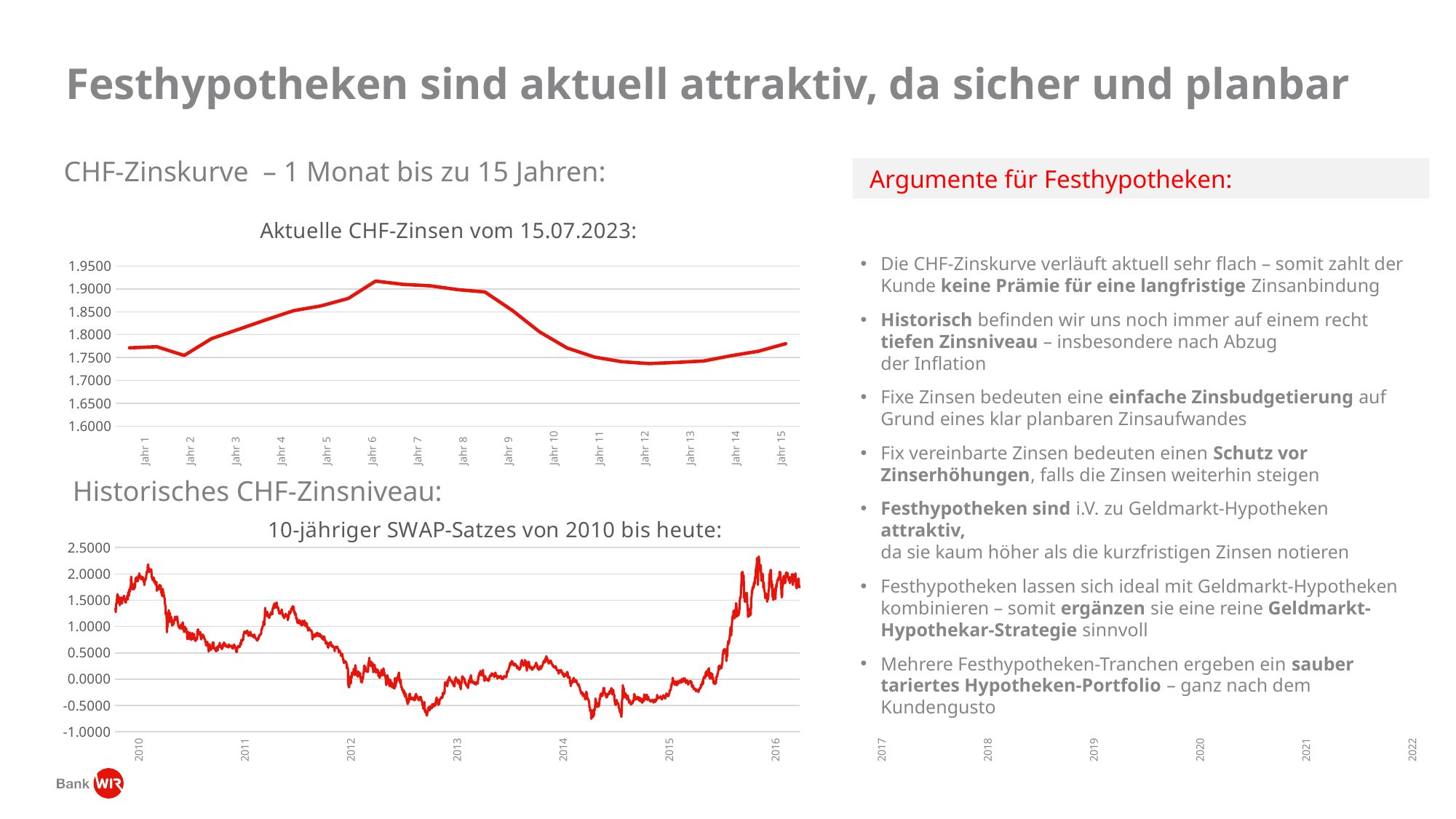
In the 'Aktuelle CHF-Zinsen vom 15.07.2023' chart, which category has the highest value? Jahr 6 In the 'Aktuelle CHF-Zinsen vom 15.07.2023' chart, do the values rise or fall from Jahr 6 to Jahr 12? fall In the 'Aktuelle CHF-Zinsen vom 15.07.2023' chart, which is larger, the value for Jahr 5 or the value for Jahr 10? Jahr 5 What kind of chart is the 'Aktuelle CHF-Zinsen vom 15.07.2023' chart? Line chart In the '10-jähriger SWAP-Satzes von 2010 bis heute' chart, is the lowest point of the line greater or less than 0.0000? less How many categories (Jahr 1 to Jahr 15) are plotted on the x axis of the 'Aktuelle CHF-Zinsen vom 15.07.2023' chart? 15 What kind of chart is the '10-jähriger SWAP-Satzes von 2010 bis heute' chart? Line chart In the 'Aktuelle CHF-Zinsen vom 15.07.2023' chart, is the value for Jahr 6 greater or less than 1.9000? greater What is the title of the lower chart on the slide? 10-jähriger SWAP-Satzes von 2010 bis heute: In the '10-jähriger SWAP-Satzes von 2010 bis heute' chart, is the highest peak of the line greater or less than 2.0000? greater